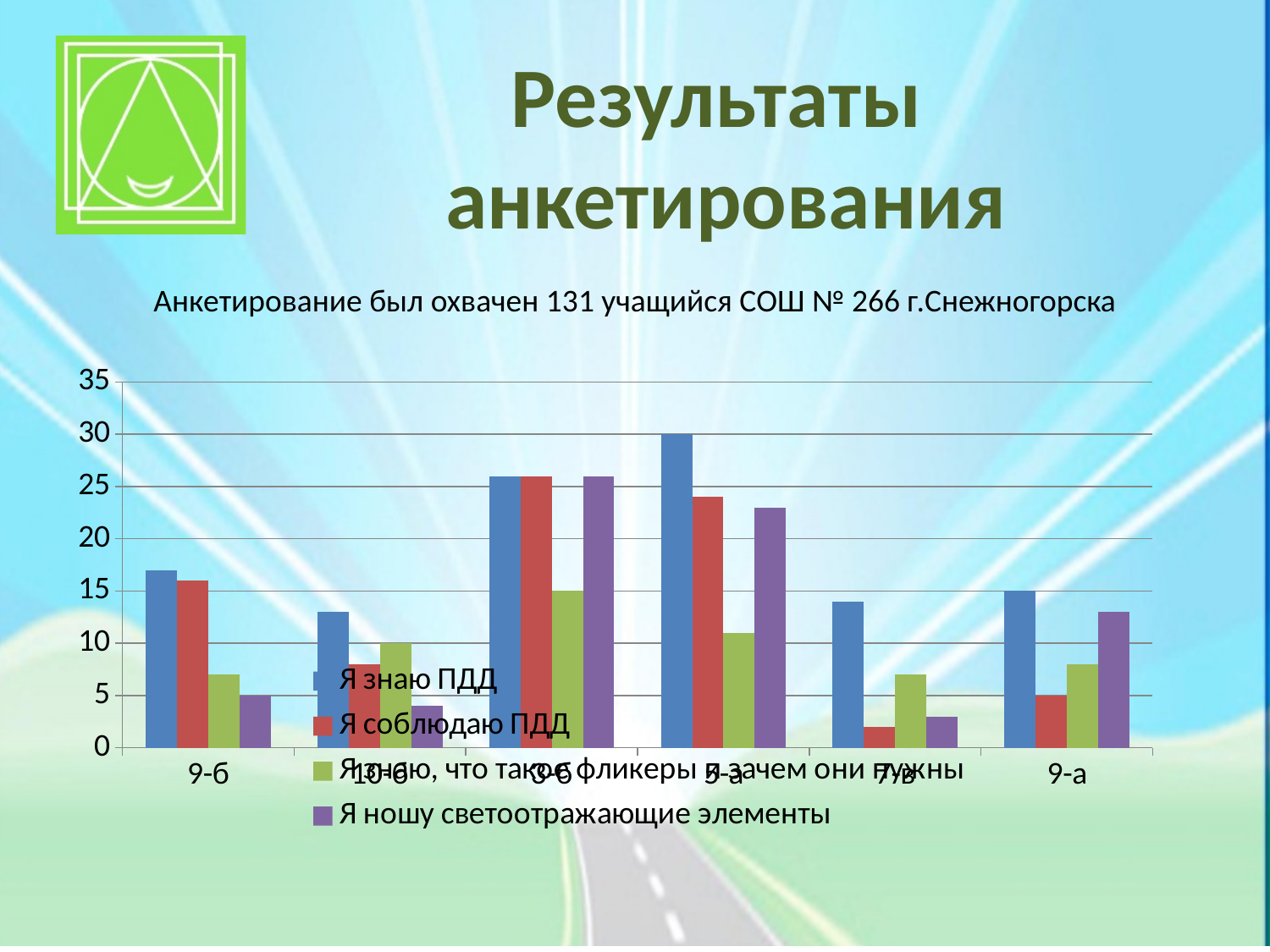
What is the value of "Я знаю ПДД" for 9-а? 15 In the 9-а group, which is larger: "Я знаю ПДД" or "Я соблюдаю ПДД"? Я знаю ПДД Is the value of "Я ношу светоотражающие элементы" for 9-а greater or less than 10? greater What is the value of "Я соблюдаю ПДД" for 9-а? 5 What colour represents "Я ношу светоотражающие элементы" in the chart? purple Is the value of "Я знаю ПДД" for 9-б greater or less than 15? greater What kind of chart is shown on the slide? bar chart Which series has the highest bar in the 9-б group? Я знаю ПДД How many category groups are plotted along the x axis? 6 What is the value of "Я ношу светоотражающие элементы" for 9-б? 5 Is the value of "Я знаю, что такое фликеры и зачем они нужны" for 9-б greater or less than 10? less How many series does the chart legend list? 4